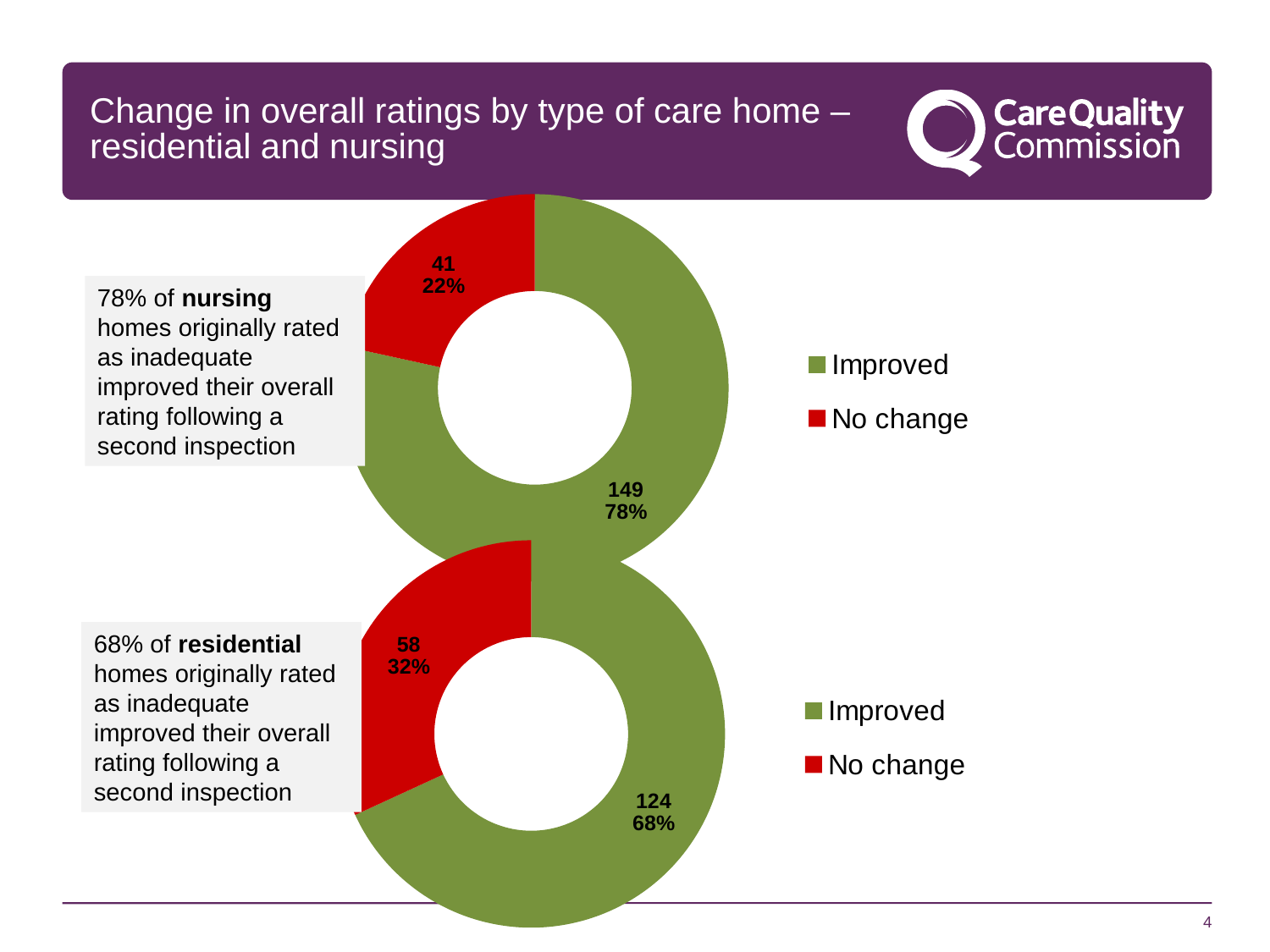
In the top (nursing homes) doughnut chart, what is the difference between the number of homes that improved and the number with no change? 108 In the bottom (residential homes) doughnut chart, what share of homes improved? 68% In the top (nursing homes) doughnut chart, what percentage of homes had no change? 22% In the bottom (residential homes) doughnut chart, how many homes had no change? 58 In the bottom (residential homes) doughnut chart, which category is smallest? No change What colour represents 'No change' in the charts? Red In the top (nursing homes) doughnut chart, which category is largest? Improved How many categories does the legend of the top (nursing homes) chart list? 2 In the bottom (residential homes) doughnut chart, what is the total number of homes shown? 182 Which is larger: the number of nursing homes that improved (top chart) or the number of residential homes that improved (bottom chart)? Nursing homes (149) In the top (nursing homes) doughnut chart, how many homes improved? 149 What type of chart is used on this slide? Doughnut (pie) chart